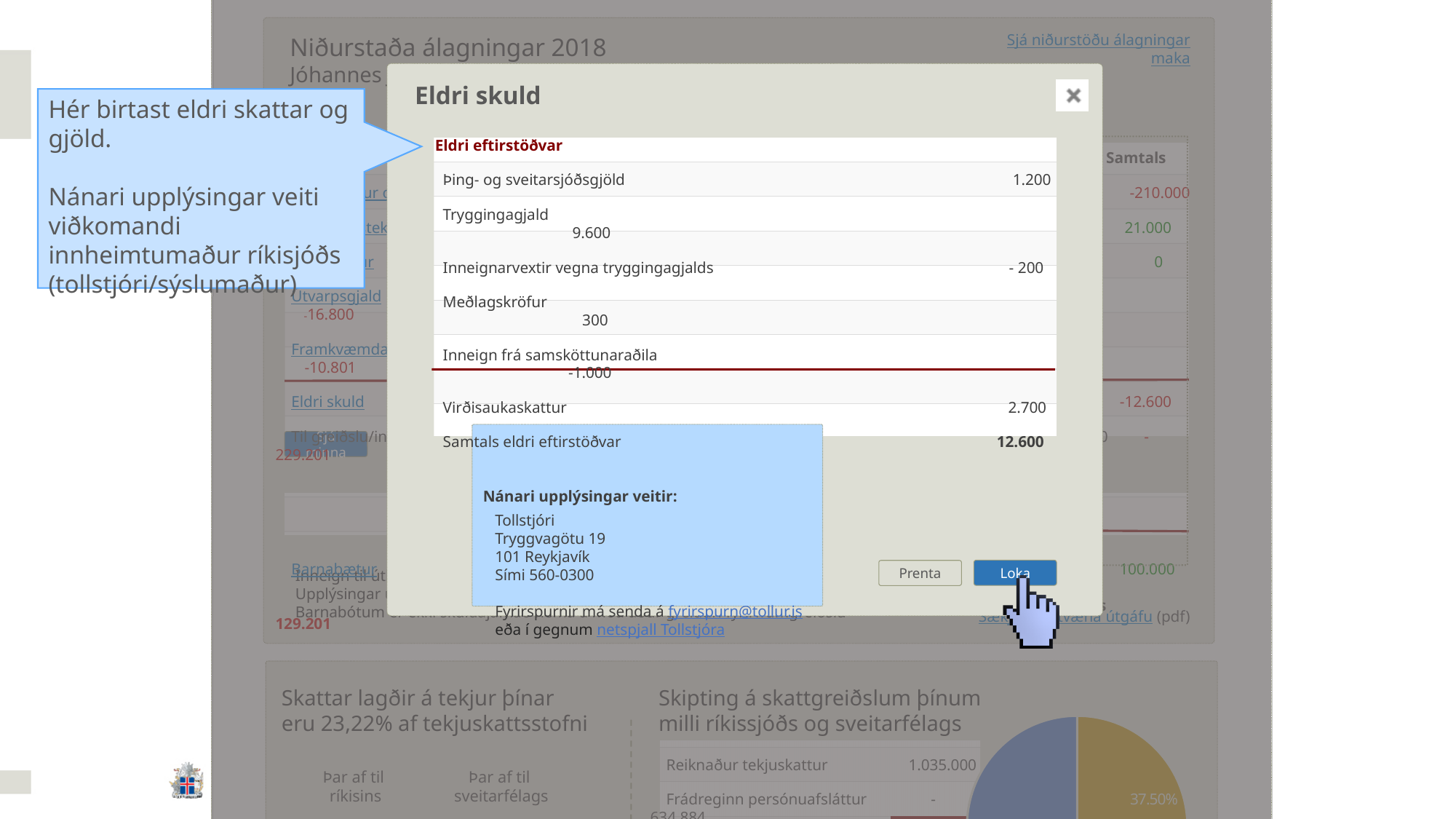
What is the title above the pie chart at the bottom right of the slide? Skipting á skattgreiðslum þínum milli ríkissjóðs og sveitarfélags On the pie chart at the bottom right of the slide, what colour is the slice labelled 37.50%? gold What percentage label is printed on the pie chart at the bottom right of the slide? 37.50% What kind of chart is shown at the bottom right of the slide, under the heading 'Skipting á skattgreiðslum þínum milli ríkissjóðs og sveitarfélags'? pie chart